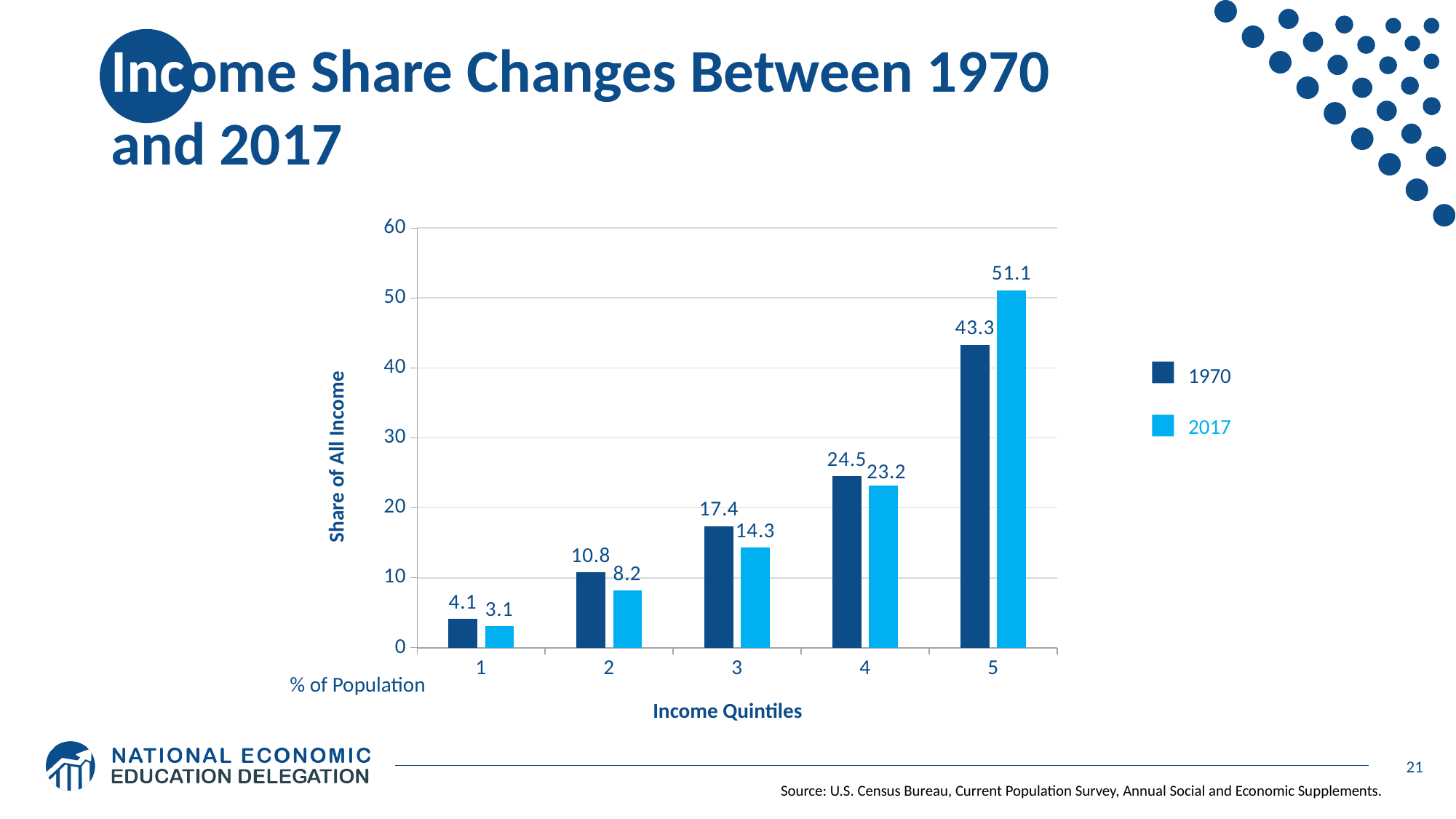
What is the difference between the 1970 and 2017 values for income quintile 2? 2.6 How many income quintiles are shown on the x axis? 5 What is the 2017 value for income quintile 3? 14.3 Is the 2017 value for income quintile 5 greater or less than 50? greater What is the 2017 share of all income for income quintile 1? 3.1 Which income quintile has the highest 2017 share of all income? 5 Which income quintile has the lowest 1970 share of all income? 1 For income quintile 4, which series has the larger value, 1970 or 2017? 1970 What kind of chart is shown on the slide? bar chart How many series does the legend list? 2 What is the difference between the 2017 and 1970 values for income quintile 5? 7.8 What is the 1970 share of all income for income quintile 5? 43.3